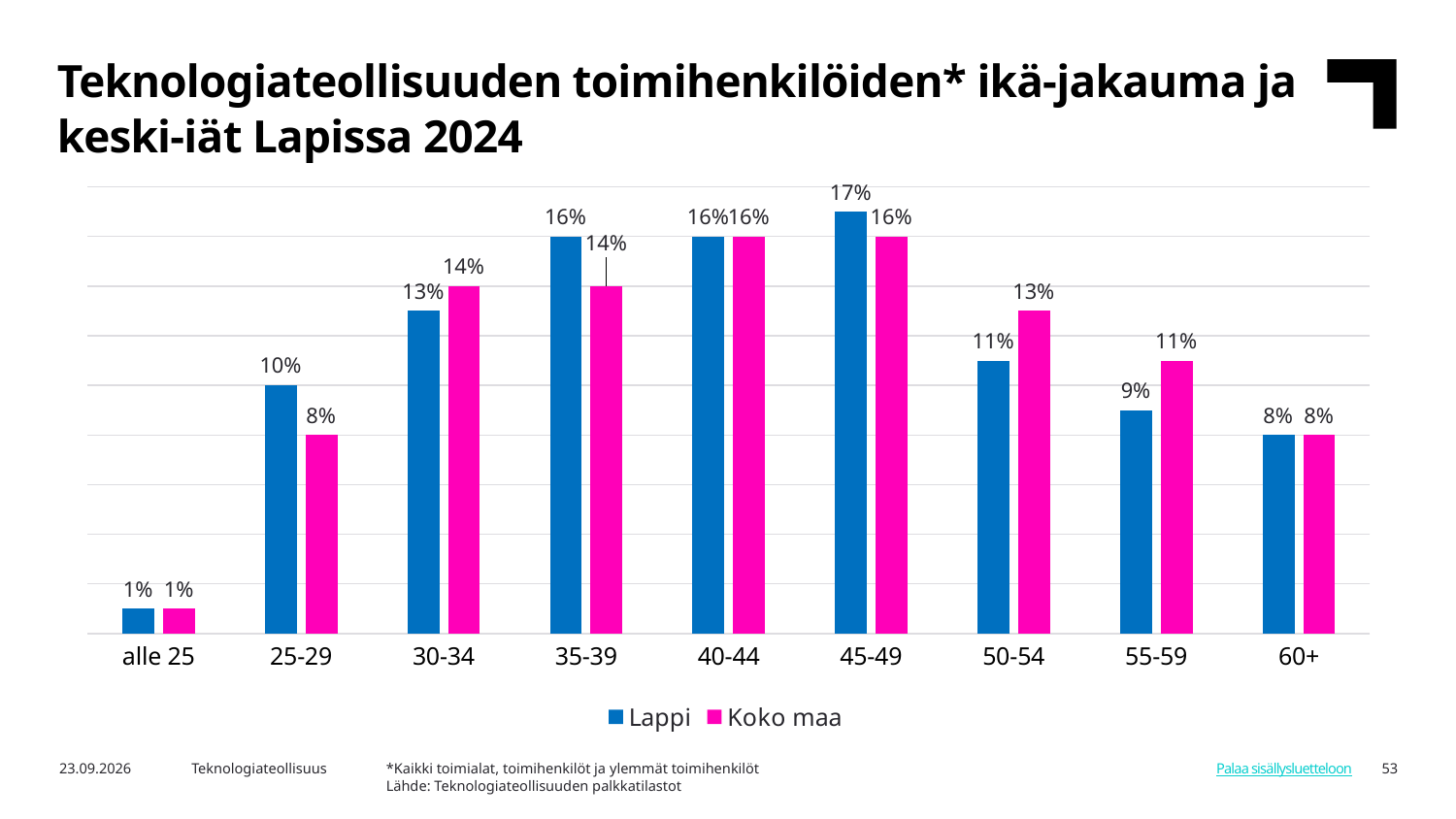
How many series does the legend list? 2 What is the value for Lappi in the 25-29 age group? 10% In the 35-39 age group, which series has the larger value, Lappi or Koko maa? Lappi What kind of chart is shown on the slide? Bar chart Which age group has the lowest value for Koko maa? alle 25 What is the difference between Lappi and Koko maa in the 55-59 age group? 2 percentage points What is the value for Lappi in the 45-49 age group? 17% Which age group has the highest value for Lappi? 45-49 What is the value for Koko maa in the 50-54 age group? 13% How many age groups are shown on the x axis? 9 In the 30-34 age group, which series has the larger value, Lappi or Koko maa? Koko maa Which series is shown in pink? Koko maa